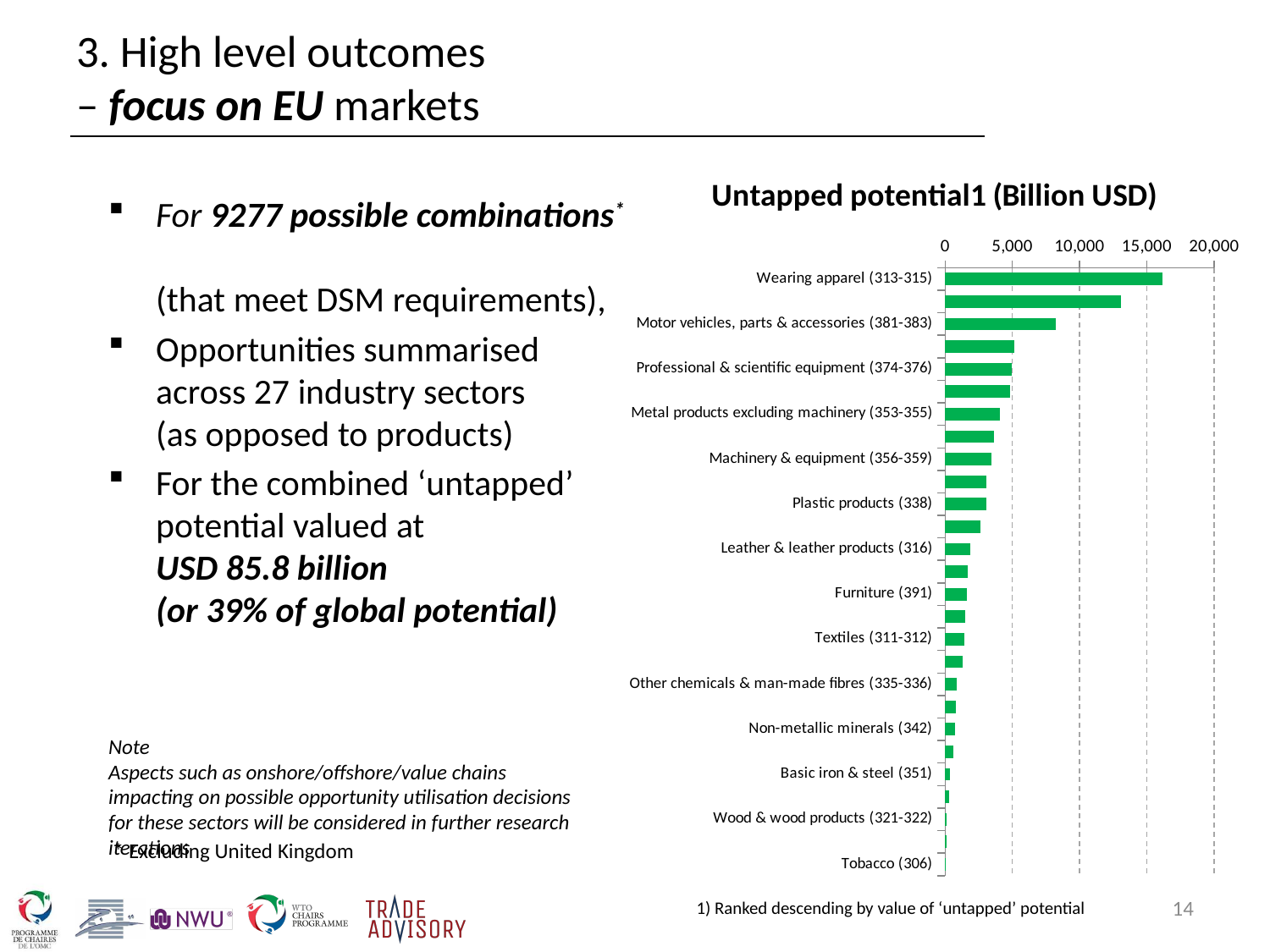
Is the value for Wearing apparel (313-315) greater or less than 15,000? greater What is the highest value shown on the chart's horizontal axis? 20,000 Which industry sector has the lowest untapped potential in the chart? Tobacco (306) Do the bar values increase or decrease going from the top of the chart to the bottom? decrease What is the title of the chart? Untapped potential1 (Billion USD) What kind of chart is shown on the slide? bar chart Which has the larger untapped potential, Plastic products (338) or Furniture (391)? Plastic products (338) Is the value for Motor vehicles, parts & accessories (381-383) greater or less than 5,000? greater Which industry sector has the highest untapped potential in the chart? Wearing apparel (313-315) Which has the larger untapped potential, Wearing apparel (313-315) or Motor vehicles, parts & accessories (381-383)? Wearing apparel (313-315) Is the value for Machinery & equipment (356-359) greater or less than 5,000? less